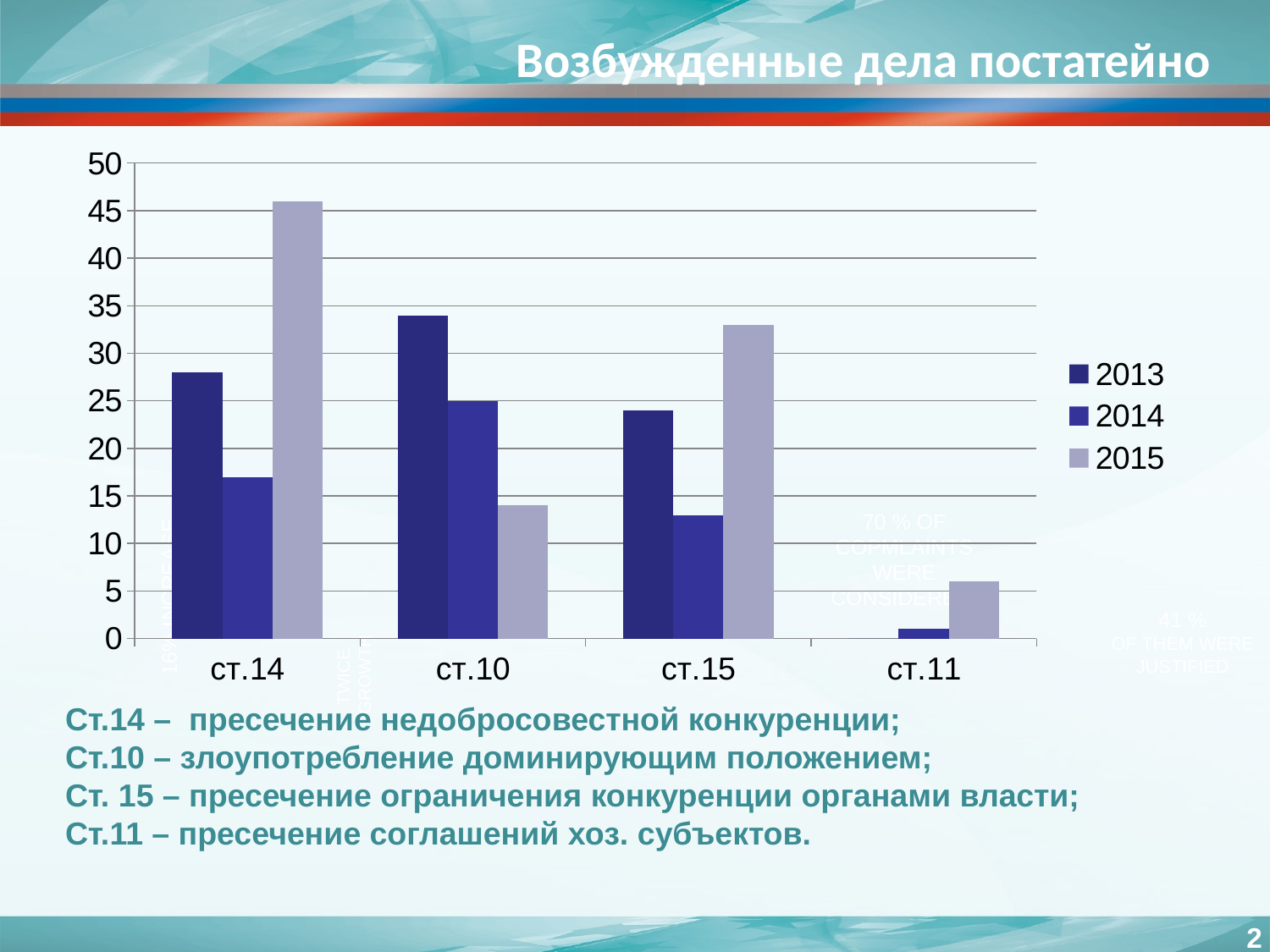
Is the value for ст.14 in 2015 greater or less than 40? greater Which is larger: the 2015 value for ст.10 or the 2015 value for ст.15? ст.15 Which category has the highest value for 2013? ст.10 Which category has the highest value for 2015? ст.14 How many series does the legend list? 3 Is the value for ст.10 in 2013 greater or less than 30? greater Which category has the lowest value for 2015? ст.11 How many categories are shown on the x axis? 4 Is the value for ст.11 in 2015 greater or less than 10? less For ст.14, which is larger: the value for 2013 or the value for 2014? 2013 What kind of chart is shown on the slide? bar chart